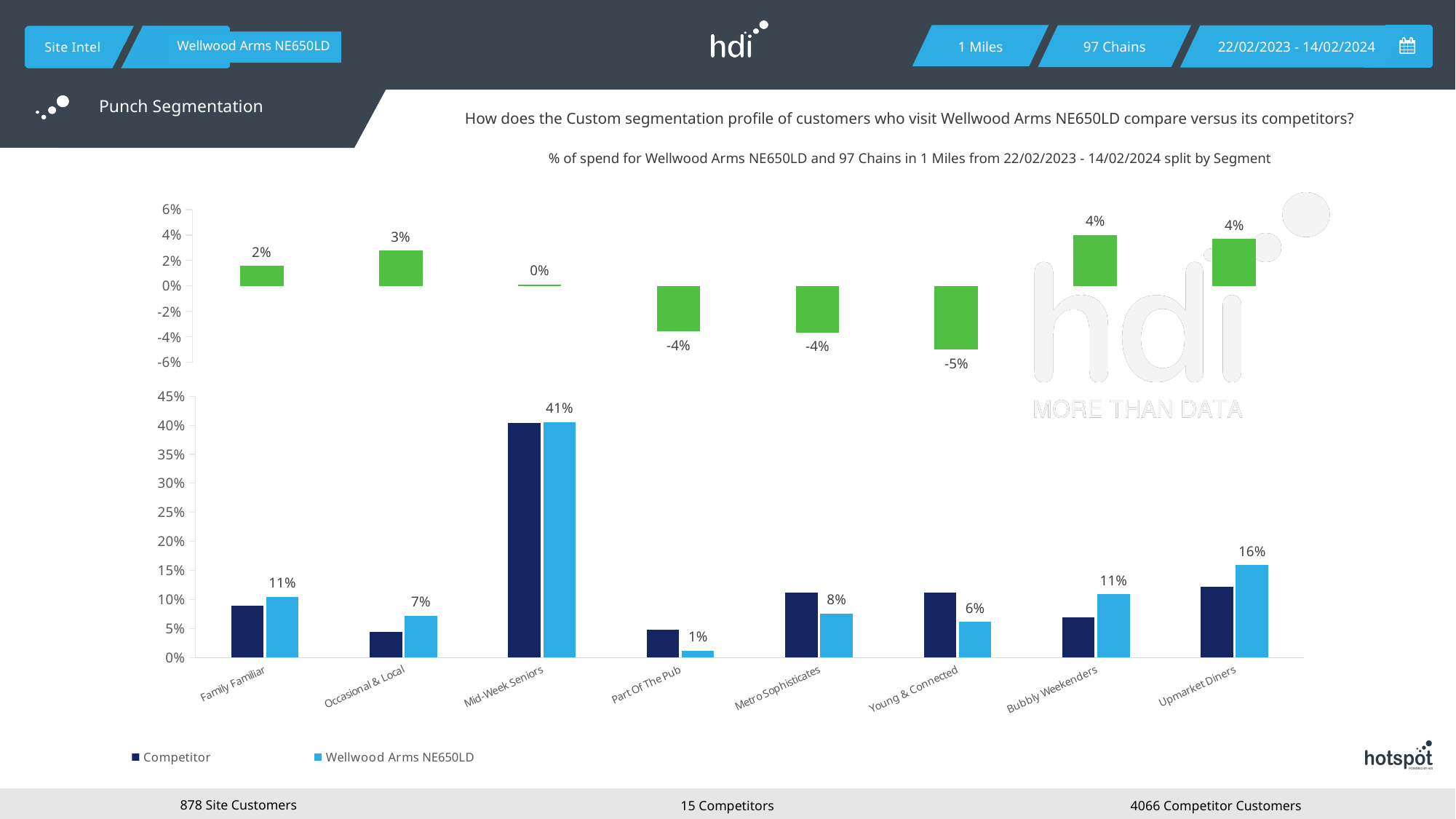
How many series does the legend of the bottom chart list? 2 In the bottom chart, what is the difference between the Wellwood Arms NE650LD values for Upmarket Diners and Bubbly Weekenders? 5% In the bottom chart, what is the value for Wellwood Arms NE650LD in the Mid-Week Seniors segment? 41% In the bottom chart, which is larger for Young & Connected: the Competitor bar or the Wellwood Arms NE650LD bar? Competitor In the bottom chart, what is the value for Wellwood Arms NE650LD in the Upmarket Diners segment? 16% In the top chart, what is the value shown for Occasional & Local? 3% In the bottom chart, which segment has the highest Wellwood Arms NE650LD value? Mid-Week Seniors In the top chart, what is the value shown for Young & Connected? -5% In the bottom chart, which segment has the lowest Wellwood Arms NE650LD value? Part Of The Pub How many segments are shown on the x axis of the bottom chart? 8 In the top chart, which segment has the lowest value? Young & Connected In the bottom chart, is the Competitor value for Metro Sophisticates greater or less than 10%? greater